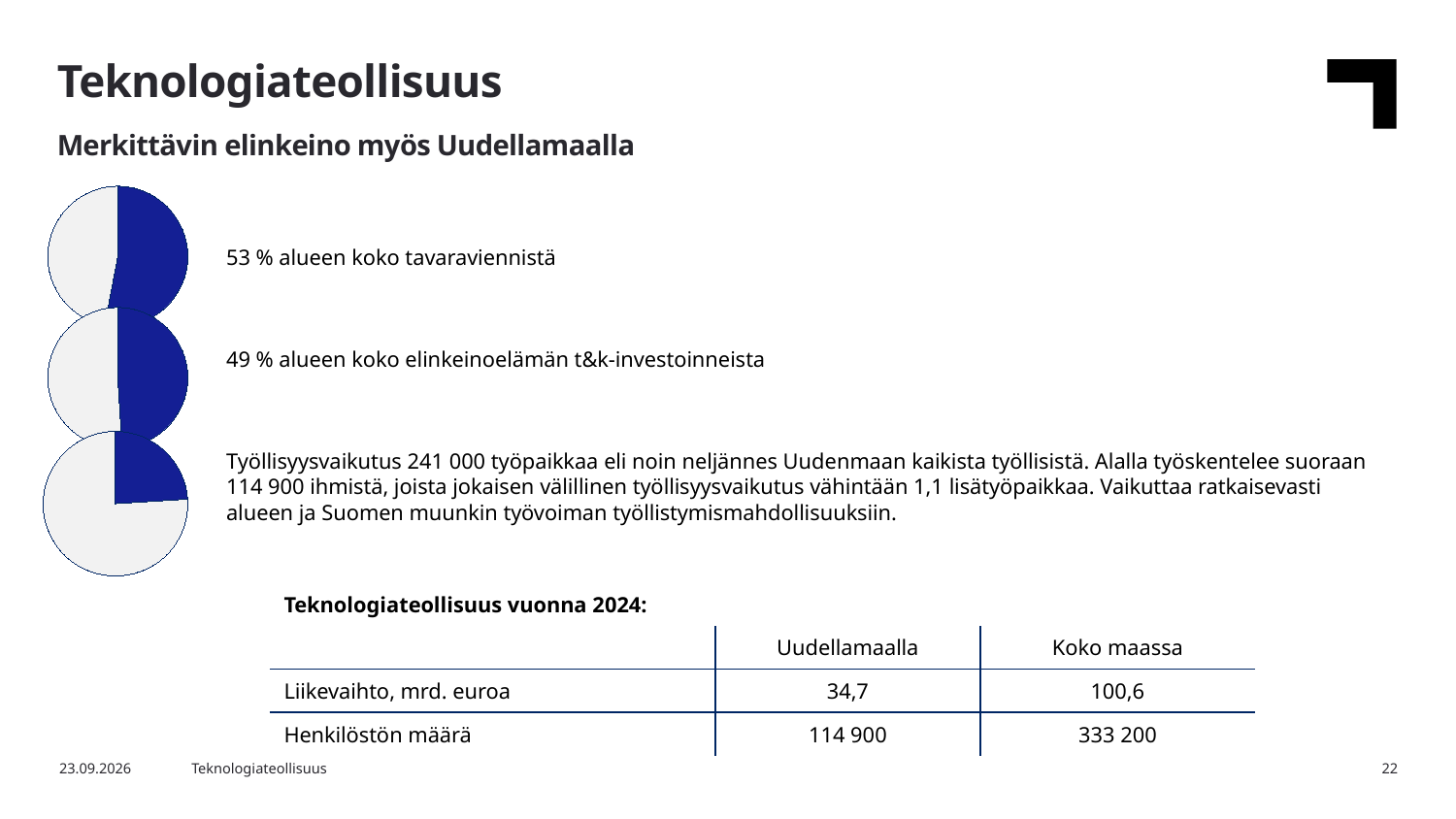
Is the dark blue slice of the top pie chart greater or less than 50% of the pie? greater What is the title of the slide containing the pie charts? Teknologiateollisuus What kind of charts are shown on the left side of the slide? Pie charts How many pie charts are on the slide? 3 Is the dark blue slice of the bottom pie chart greater or less than 50% of the pie? less Which pie chart has the smallest dark blue slice: the top, middle or bottom one? Bottom In the middle pie chart, what share of the region's business R&D investments does the dark blue slice represent? 49 % Which has a larger dark blue slice, the top pie chart or the bottom pie chart? Top pie chart What colour is used for the highlighted slice in each pie chart? Dark blue In the top pie chart, what share of the region's total goods exports does the dark blue slice represent? 53 % Which has a larger dark blue share, the top pie chart (goods exports) or the middle pie chart (R&D investments)? Top pie chart (53 %) What is the difference between the dark blue shares of the top and middle pie charts? 4 percentage points